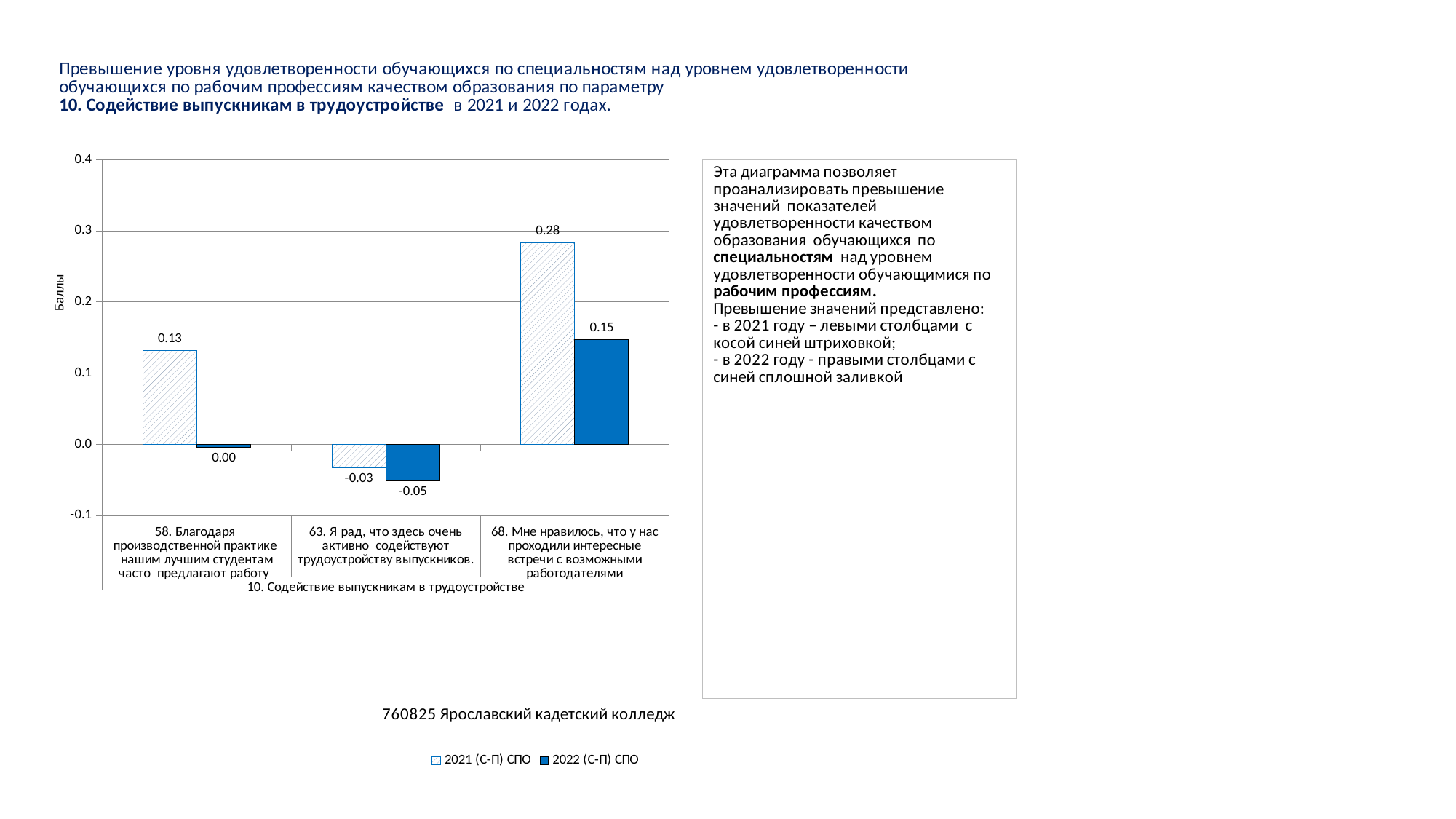
What is the difference between the 2021 and 2022 values for category 68? 0.13 For category 58, which series has the larger value, 2021 (С-П) СПО or 2022 (С-П) СПО? 2021 (С-П) СПО What is the value for 2021 (С-П) СПО for category 63? -0.03 Which category has the lowest value for the 2022 (С-П) СПО series? 63. Я рад, что здесь очень активно содействуют трудоустройству выпускников. How many categories are shown on the x axis of the chart? 3 What is the label of the vertical axis of the chart? Баллы What is the value for 2021 (С-П) СПО for category 58 (Благодаря производственной практике нашим лучшим студентам часто предлагают работу)? 0.13 How many series does the chart legend list? 2 What is the value for 2022 (С-П) СПО for category 63 (Я рад, что здесь очень активно содействуют трудоустройству выпускников)? -0.05 Which category has the highest value for the 2021 (С-П) СПО series? 68. Мне нравилось, что у нас проходили интересные встречи с возможными работодателями What is the value for 2022 (С-П) СПО for category 68 (Мне нравилось, что у нас проходили интересные встречи с возможными работодателями)? 0.15 What type of chart is shown on the slide? bar chart